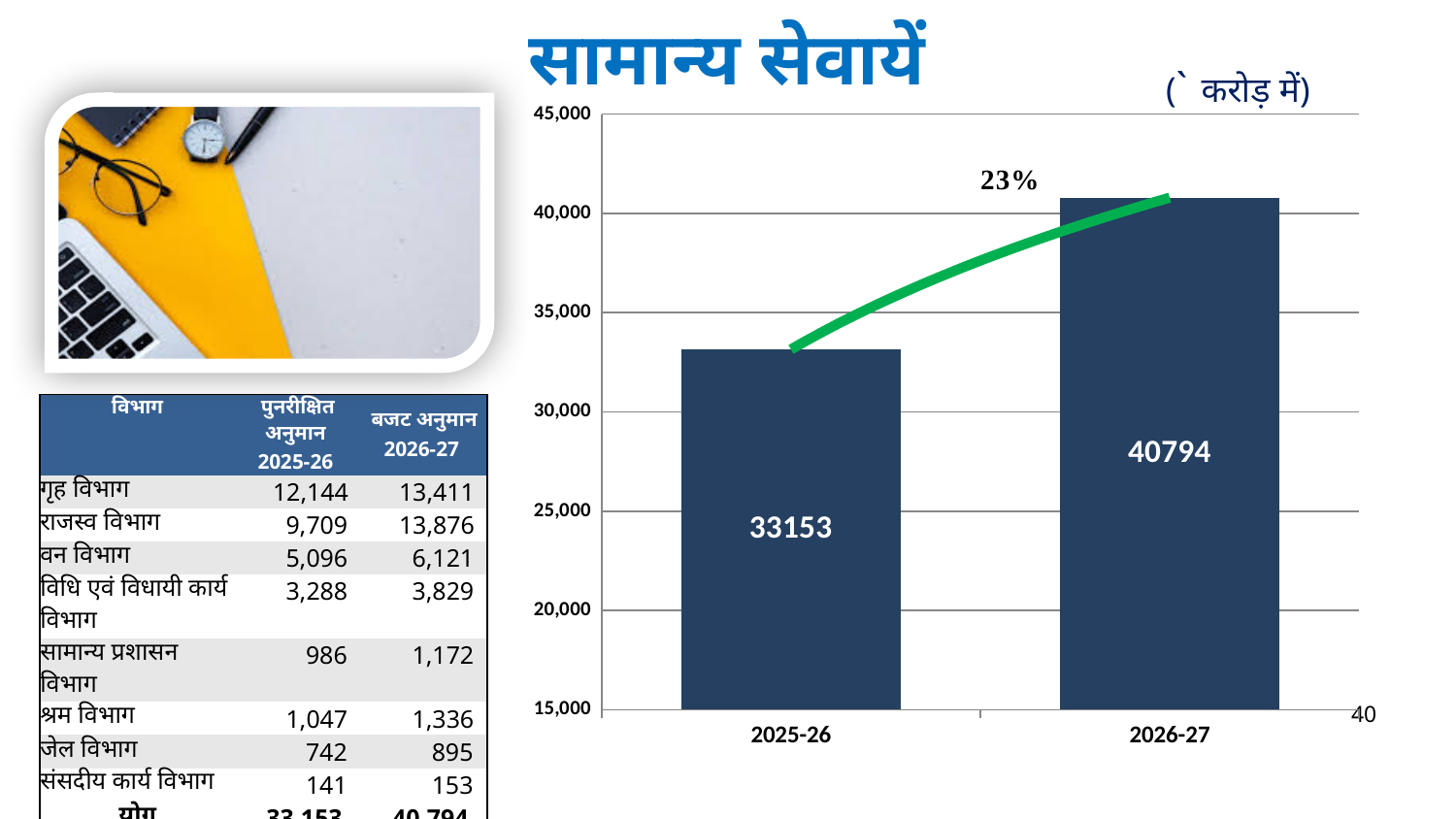
What kind of chart is shown on the slide? Bar chart What is the value for 2026-27? 40794 Do the values rise or fall from 2025-26 to 2026-27? Rise What is the value for 2025-26? 33153 Which year has the lower value? 2025-26 Is the value for 2025-26 greater or less than 35,000? less Is the value for 2026-27 greater or less than 40,000? greater What is the difference between the values for 2026-27 and 2025-26? 7641 How many bars are shown in the chart? 2 What percentage growth is annotated above the bars? 23% Is the value for 2026-27 larger than the value for 2025-26? Yes Which year has the higher value? 2026-27